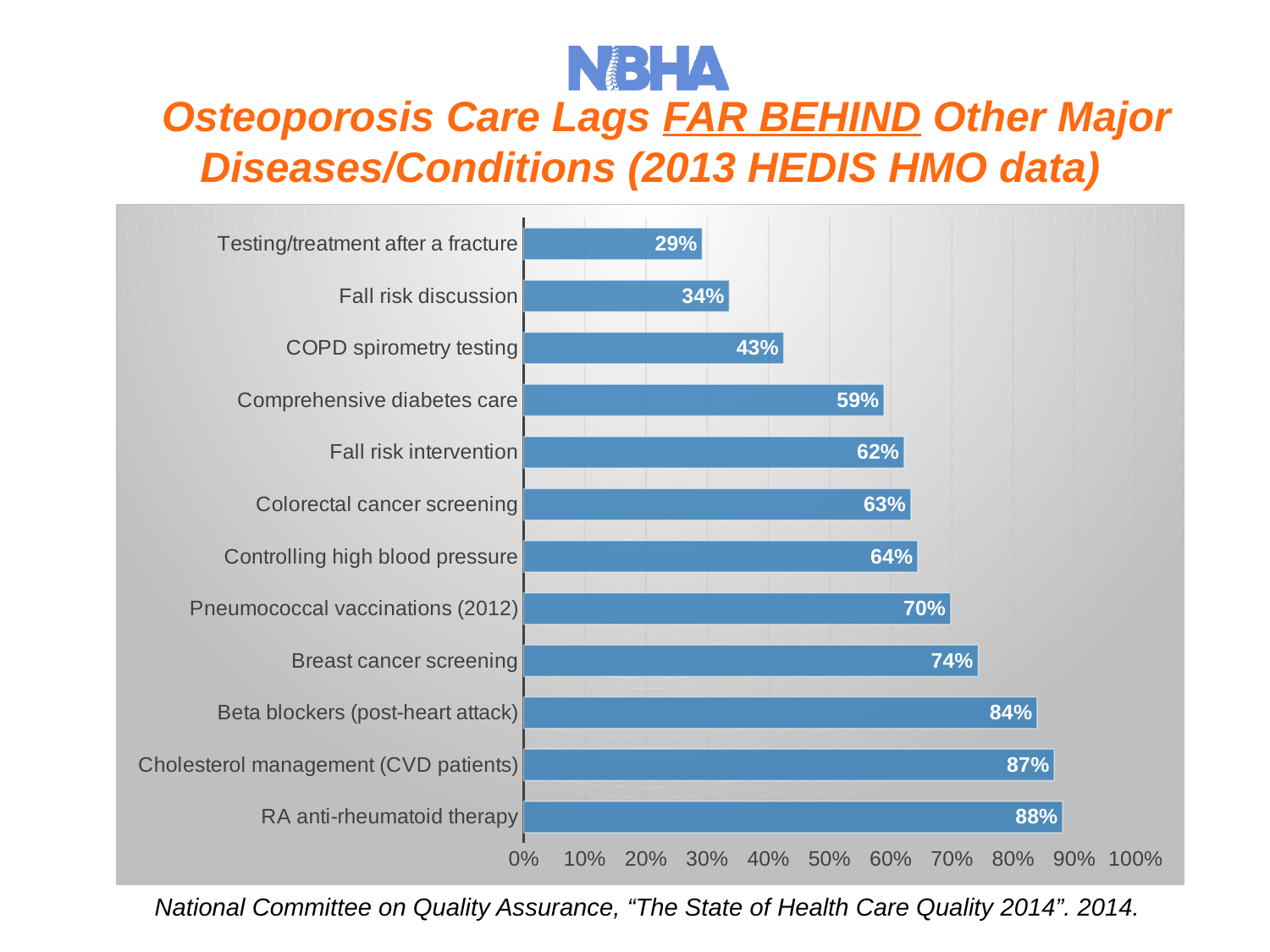
What is the maximum value shown on the horizontal axis? 100% Which is larger, the value for Fall risk discussion or the value for Pneumococcal vaccinations (2012)? Pneumococcal vaccinations (2012) What is the value for Comprehensive diabetes care? 59% What is the value for Testing/treatment after a fracture? 29% Which category has the lowest value? Testing/treatment after a fracture Which category has the highest value? RA anti-rheumatoid therapy How many categories are shown in the chart? 12 What is the difference between the values for RA anti-rheumatoid therapy and Testing/treatment after a fracture? 59% What kind of chart is shown on the slide? Bar chart What is the value for Beta blockers (post-heart attack)? 84% What is the difference between the values for Breast cancer screening and COPD spirometry testing? 31% Is the value for Cholesterol management (CVD patients) greater or less than 80%? greater